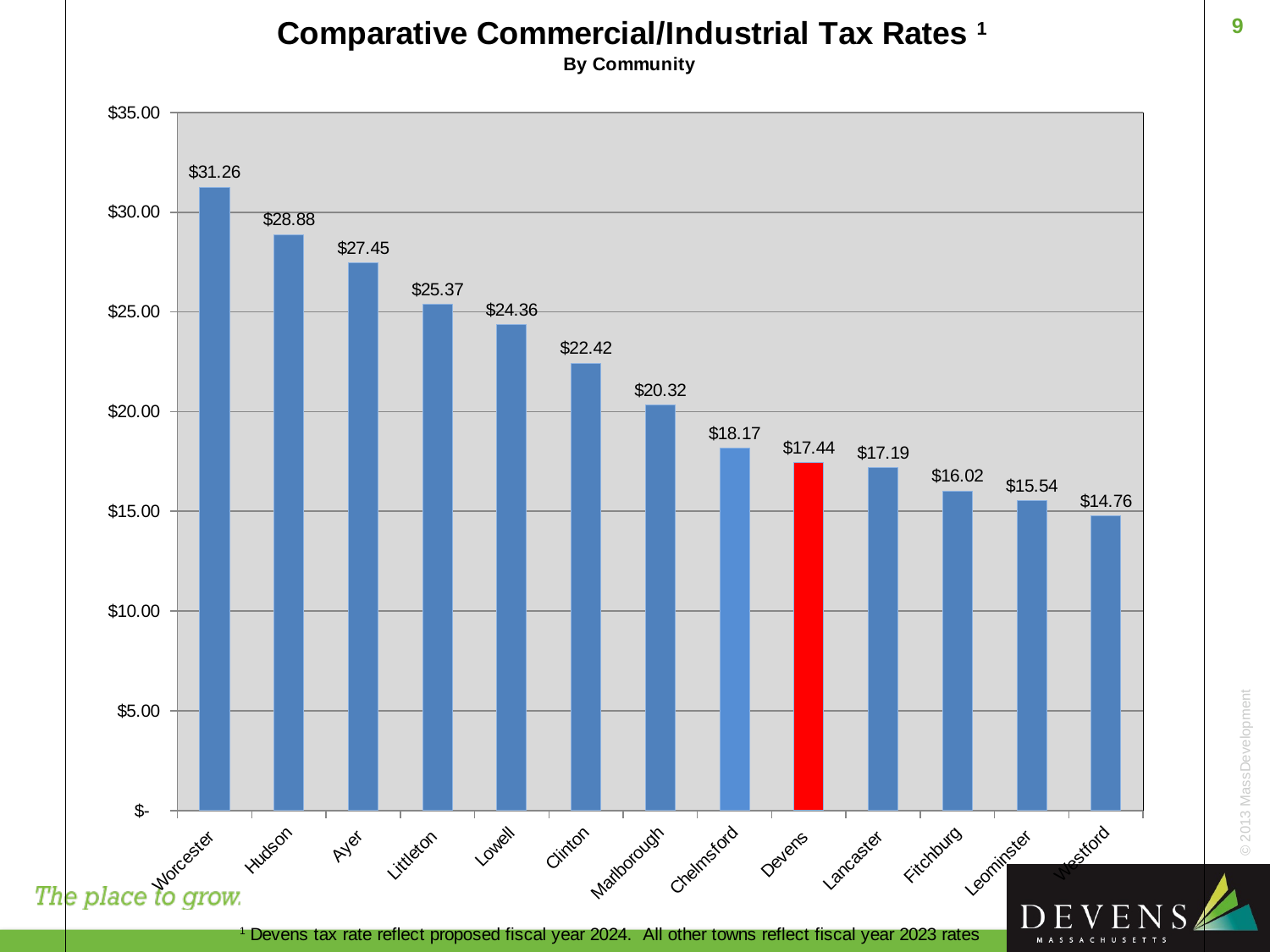
Which community has the lowest tax rate on the chart? Westford What is the tax rate shown for Littleton? $25.37 What is the difference between the tax rates of Worcester and Hudson? $2.38 Is the value for Chelmsford greater or less than $20.00? less What is the commercial/industrial tax rate shown for Devens? $17.44 Which has a higher tax rate, Clinton or Marlborough? Clinton Do the tax rates rise or fall moving from left to right across the chart? fall What type of chart is shown on the slide? bar chart How many communities are shown on the chart? 13 What is the difference between the tax rates of Devens and Lancaster? $0.25 Which community's bar is coloured red? Devens Which community has the highest tax rate on the chart? Worcester